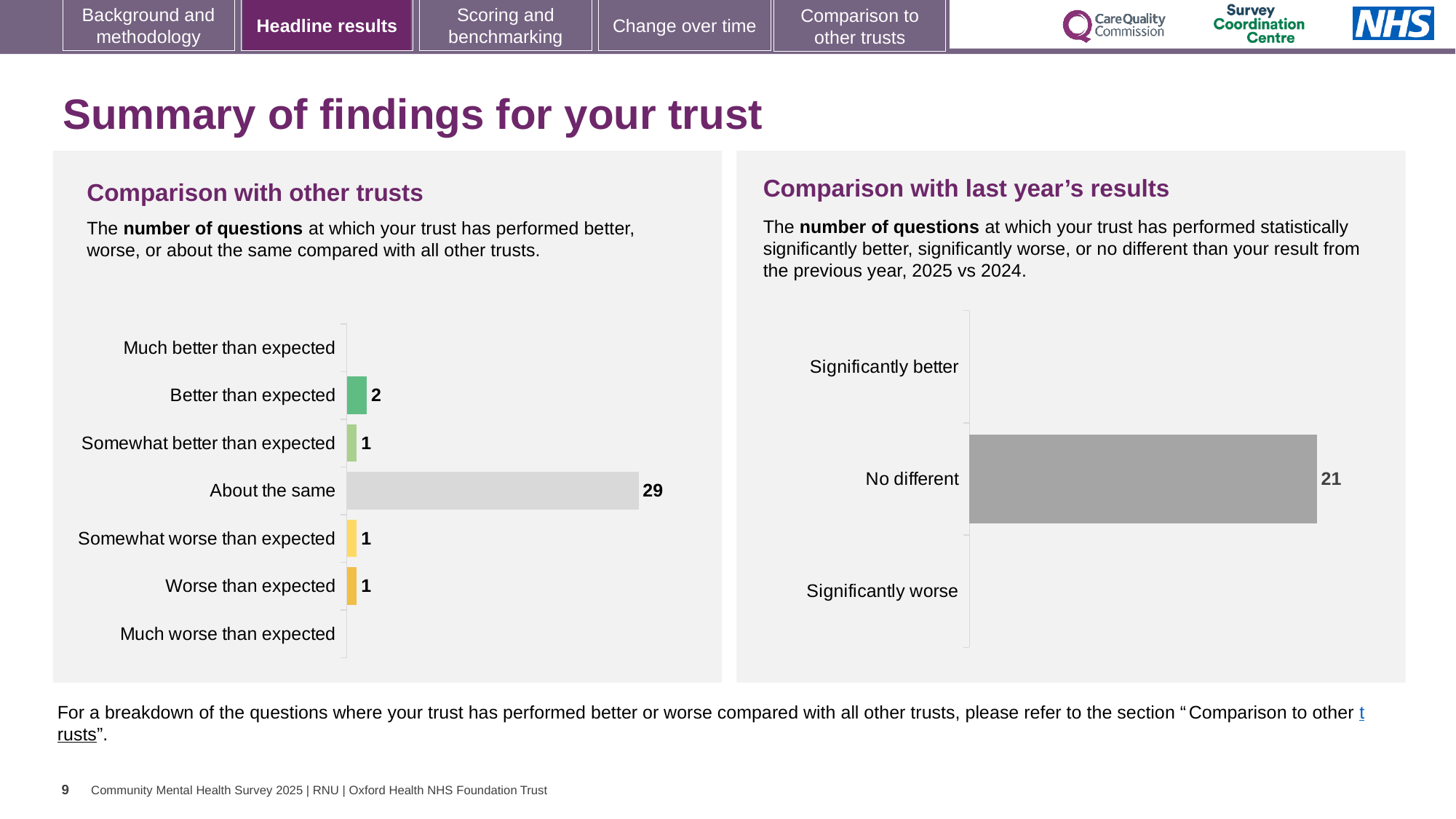
In the 'Comparison with last year's results' chart, which category has the highest number of questions? No different In the 'Comparison with other trusts' chart, how many questions are 'Better than expected'? 2 In the 'Comparison with other trusts' chart, which category has the highest number of questions? About the same In the 'Comparison with other trusts' chart, what is the difference between 'About the same' and 'Better than expected'? 27 How many categories are listed on the 'Comparison with other trusts' chart? 7 In the 'Comparison with other trusts' chart, which is larger: 'Better than expected' or 'Worse than expected'? Better than expected In the 'Comparison with last year's results' chart, how many questions are 'No different'? 21 How many categories are listed on the 'Comparison with last year's results' chart? 3 In the 'Comparison with other trusts' chart, what is the total of 'Better than expected' and 'Somewhat better than expected'? 3 In the 'Comparison with other trusts' chart, how many questions are 'About the same'? 29 In the 'Comparison with other trusts' chart, how many questions are 'Somewhat worse than expected'? 1 What type of chart is the 'Comparison with other trusts' chart? Bar chart